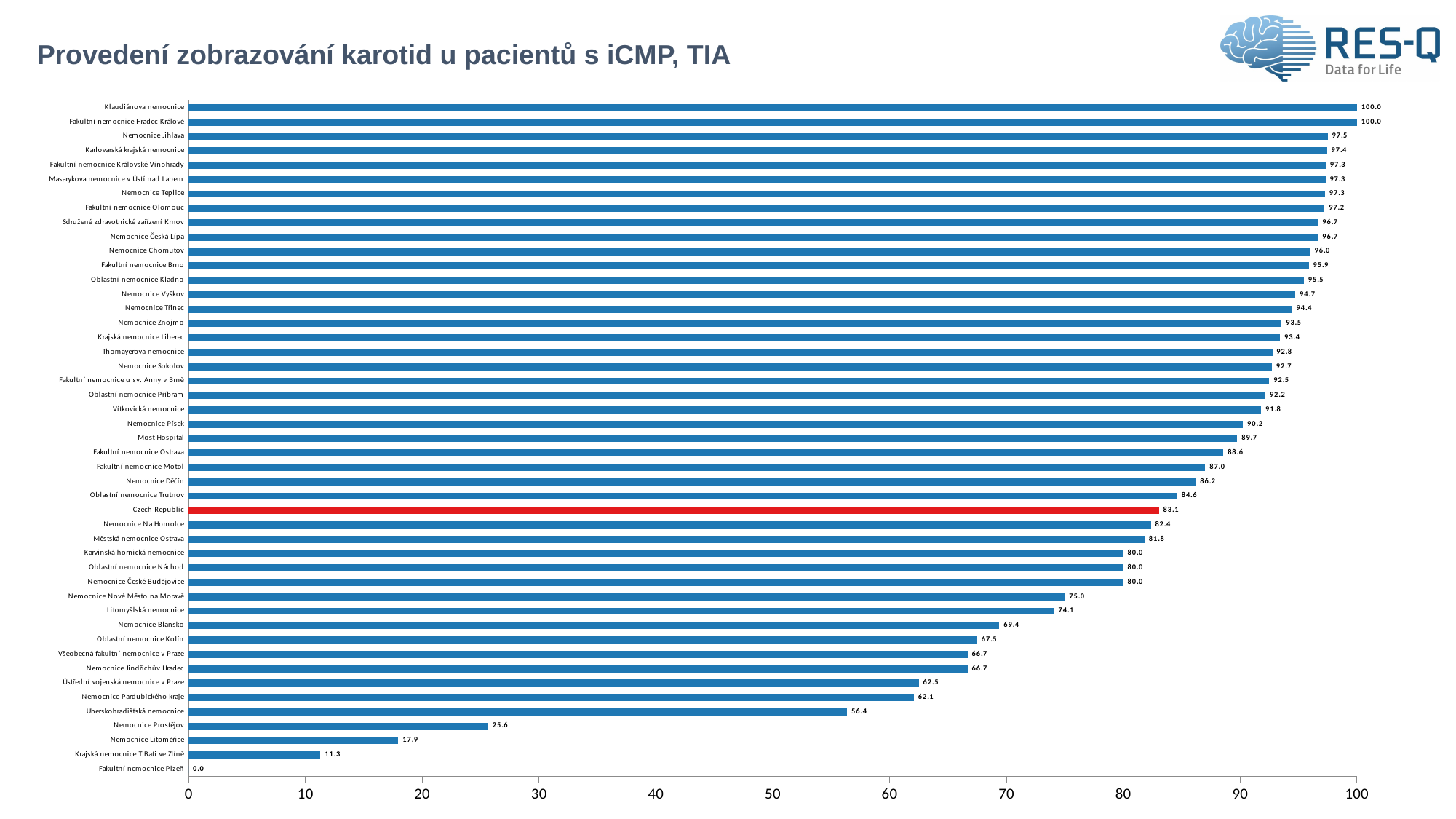
What is the value for Fakultní nemocnice Motol? 87.0 Which bar is highlighted in red? Czech Republic What is the difference between the values for Nemocnice Jihlava and Nemocnice Blansko? 28.1 Which category has the lowest value? Fakultní nemocnice Plzeň What is the value for Nemocnice Prostějov? 25.6 What is the value for Czech Republic? 83.1 What is the difference between the values for Czech Republic and Nemocnice Litoměřice? 65.2 Is the value for Krajská nemocnice T.Bati ve Zlíně greater or less than 20? less What kind of chart is shown on the slide? bar chart Which is larger, the value for Nemocnice Děčín or the value for Nemocnice Na Homolce? Nemocnice Děčín How many bars are plotted on the chart? 47 What is the value for Uherskohradišťská nemocnice? 56.4